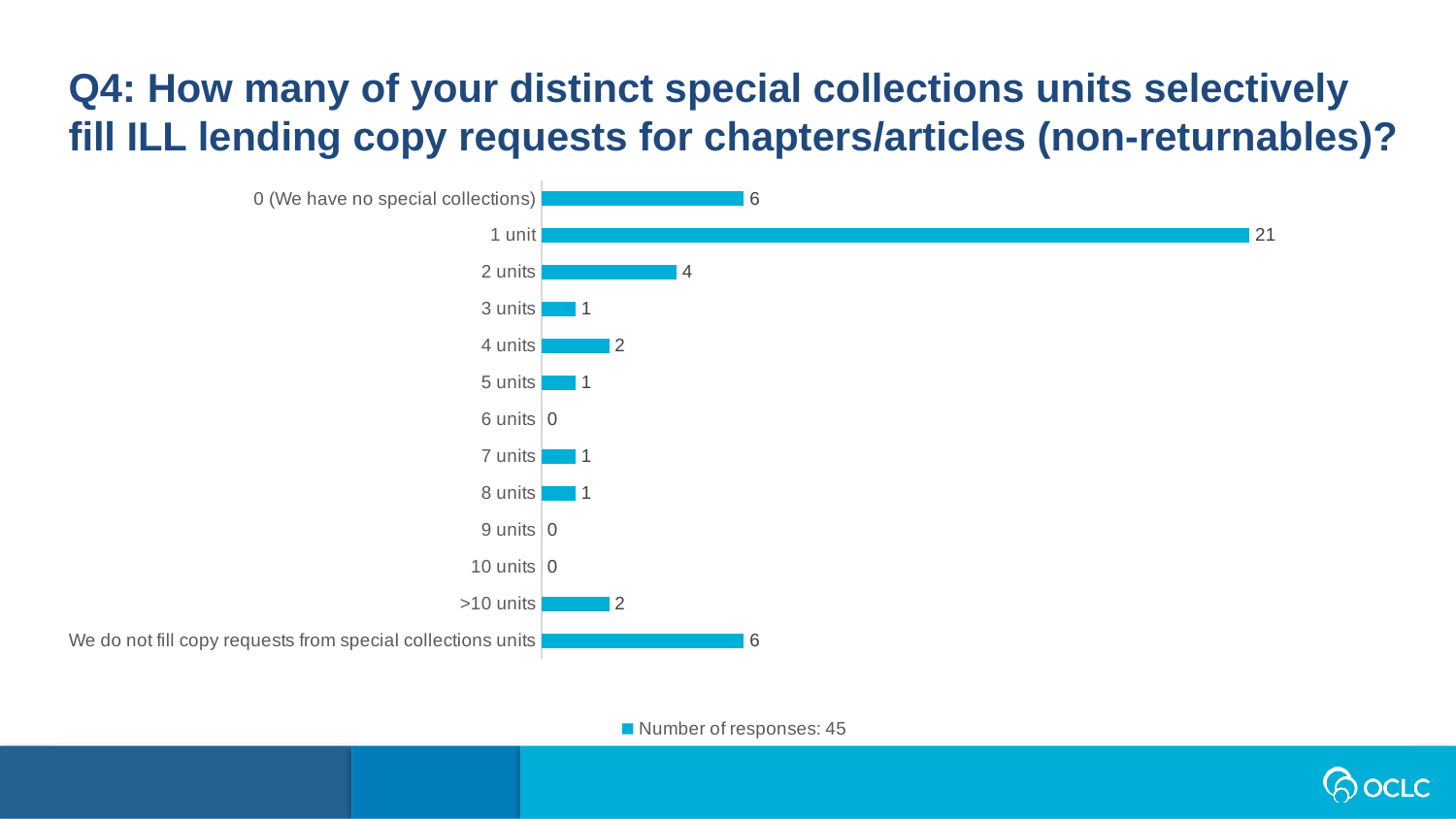
What is the value for "1 unit"? 21 How many series does the legend list? 1 How many categories are shown on the chart? 13 What is the value for "2 units"? 4 What is the value for "We do not fill copy requests from special collections units"? 6 Which category has the highest value? 1 unit Which is larger, the value for "4 units" or the value for "3 units"? 4 units What kind of chart is shown on the slide? Bar chart How many categories have a value of 0? 3 What is the difference between the values for "1 unit" and "2 units"? 17 What is the value for ">10 units"? 2 What is the legend entry shown below the chart? Number of responses: 45